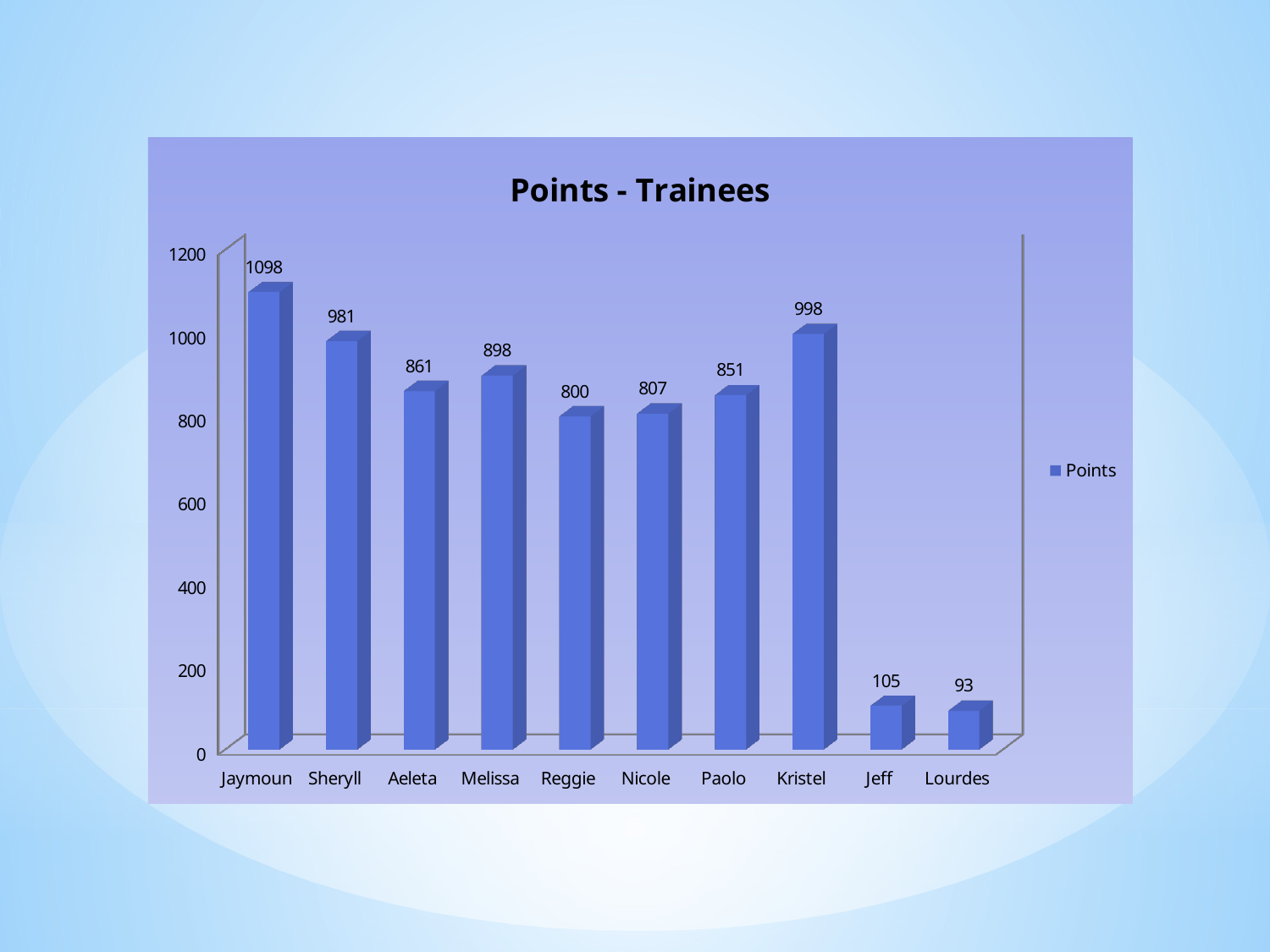
What is the title of the chart? Points - Trainees Which is larger, the value for Melissa or the value for Paolo? Melissa What kind of chart is shown? bar chart Is the value for Reggie greater or less than 1000? less How many trainees are shown on the x axis? 10 What is the value for Kristel? 998 What is the value for Lourdes? 93 What is the difference between the values for Sheryll and Aeleta? 120 What is the value for Jaymoun? 1098 Which trainee has the highest points? Jaymoun How many series does the legend list? 1 Which trainee has the lowest points? Lourdes